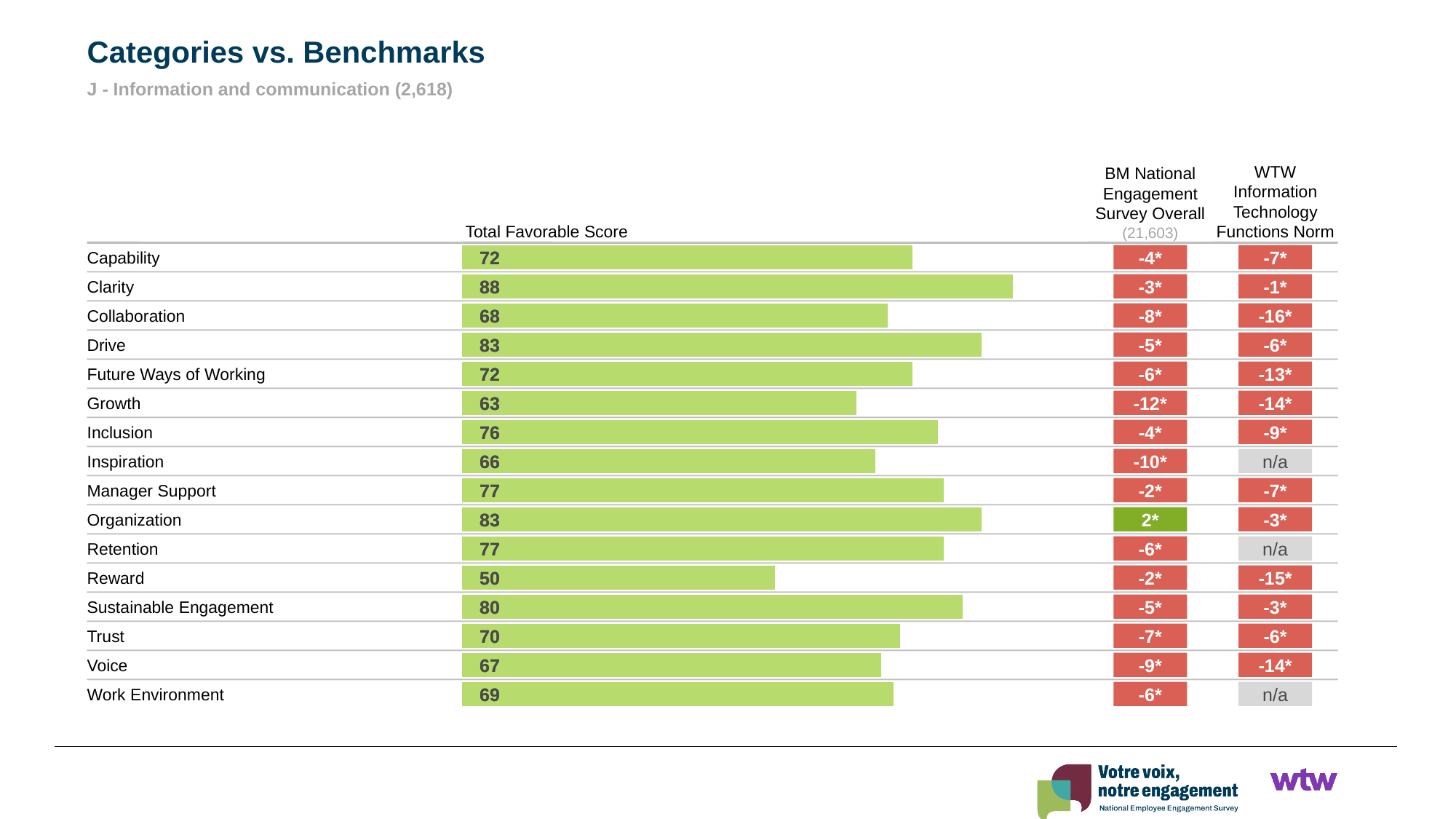
What is the sample size shown in the subtitle for J - Information and communication? 2,618 What is the difference between the Total Favorable Scores for Clarity and Growth? 25 What is the Total Favorable Score for Reward? 50 Which category is the only one with a positive difference versus the BM National Engagement Survey Overall? Organization Which category has the lowest Total Favorable Score? Reward What is the Total Favorable Score for Clarity? 88 What is the BM National Engagement Survey Overall difference shown for Growth? -12* What is the WTW Information Technology Functions Norm difference shown for Collaboration? -16* Which has a higher Total Favorable Score, Inclusion or Trust? Inclusion Which category has the highest Total Favorable Score? Clarity How many categories are shown in the chart? 16 What kind of chart is used to show the Total Favorable Score? Bar chart